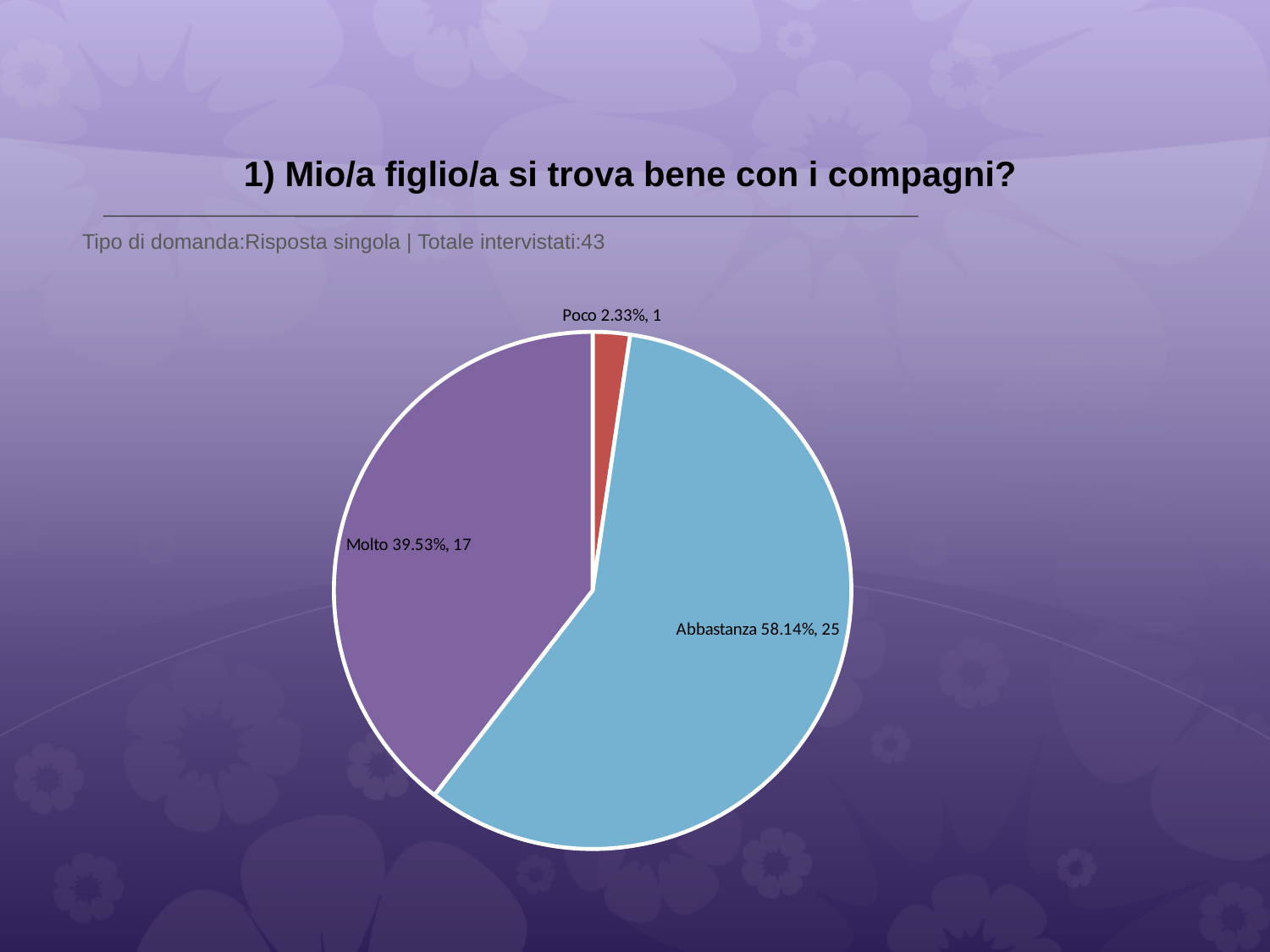
How many slices does the pie chart have? 3 What percentage share does the 'Poco' slice represent? 2.33% Which has more respondents, 'Molto' or 'Poco'? Molto What percentage share does the 'Abbastanza' slice represent? 58.14% How many respondents answered 'Molto'? 17 What percentage share does the 'Molto' slice represent? 39.53% How many respondents answered 'Poco'? 1 Which category has the largest slice of the pie? Abbastanza Which category has the smallest slice of the pie? Poco What is the difference in number of respondents between 'Abbastanza' and 'Molto'? 8 How many respondents answered 'Abbastanza'? 25 What kind of chart is shown on the slide? pie chart